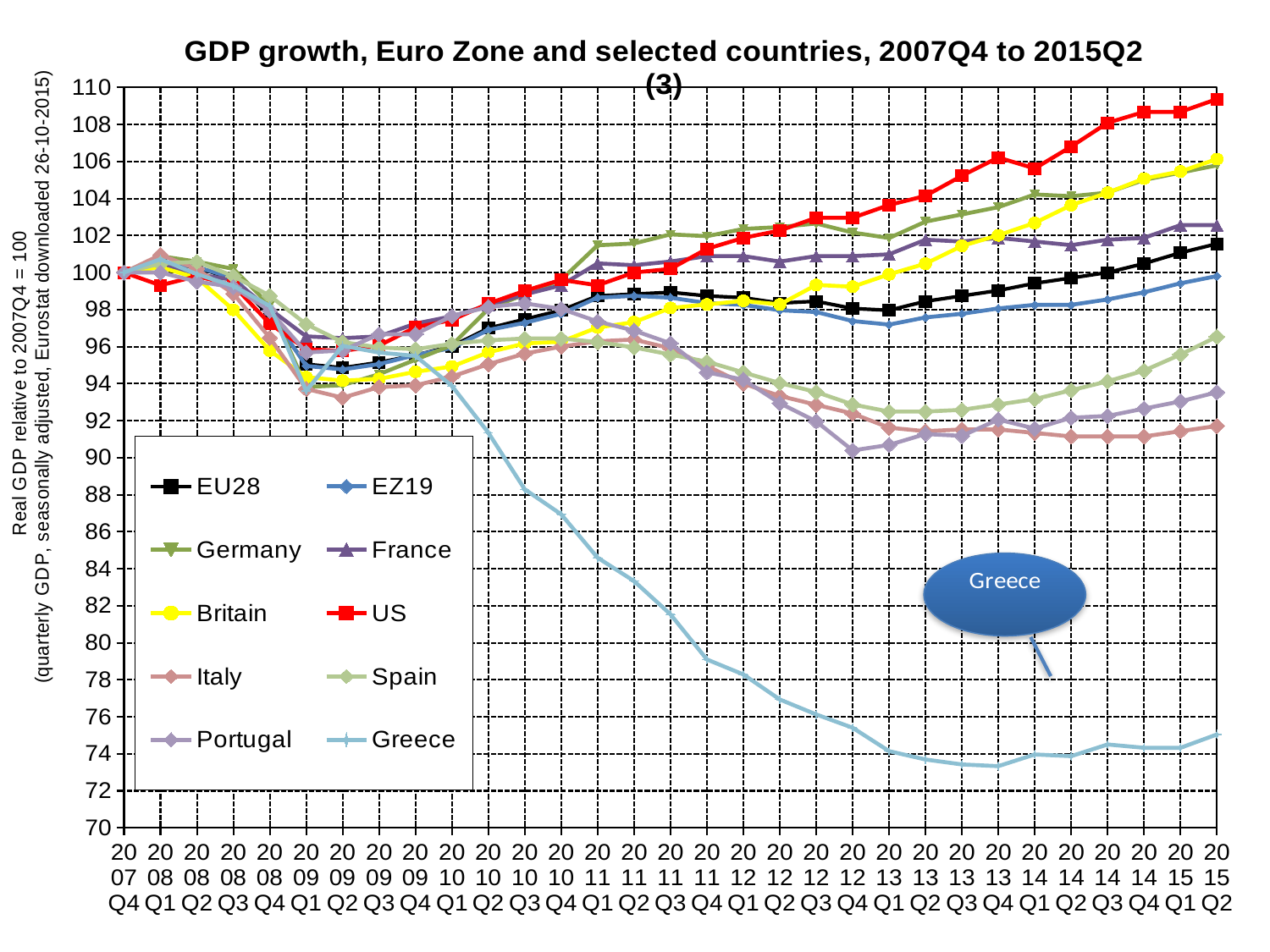
Does the US line rise or fall overall from 2009 Q2 to 2015 Q2? rise Does the Greece line rise or fall overall from 2007 Q4 to 2015 Q2? fall Which country or region has the highest value at 2015 Q2? US Which country or region has the lowest value at 2015 Q2? Greece What kind of chart is shown on the slide? line chart What is the title of the chart? GDP growth, Euro Zone and selected countries, 2007Q4 to 2015Q2 (3) Is the value for Greece at 2015 Q2 greater or less than 80? less At 2015 Q2, which is higher, Germany or France? Germany How many series does the legend list? 10 How many quarters are plotted along the x axis? 31 At 2015 Q2, which is higher, Italy or Portugal? Portugal Is the value for the US at 2015 Q2 greater or less than 108? greater